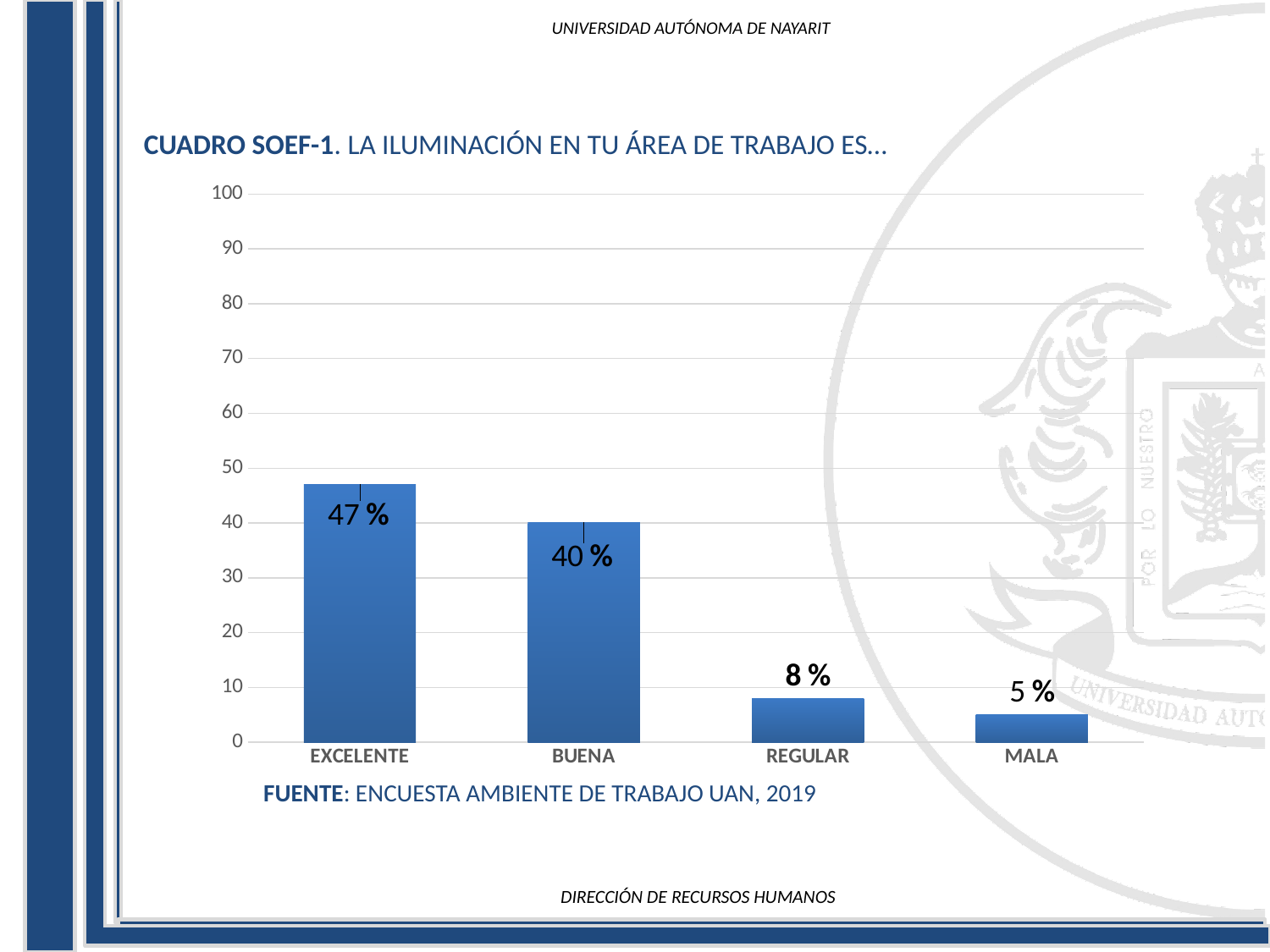
How many categories are shown on the x axis? 4 Which is larger, the value for REGULAR or the value for MALA? REGULAR Which category has the lowest value? MALA What source is cited below the chart? ENCUESTA AMBIENTE DE TRABAJO UAN, 2019 What is the value for BUENA? 40 % What is the value for REGULAR? 8 % What is the value for EXCELENTE? 47 % Which category has the highest value? EXCELENTE Is the value for BUENA greater or less than 50? less What is the difference between the values for EXCELENTE and BUENA? 7 % What is the value for MALA? 5 % What kind of chart is shown on the slide? bar chart